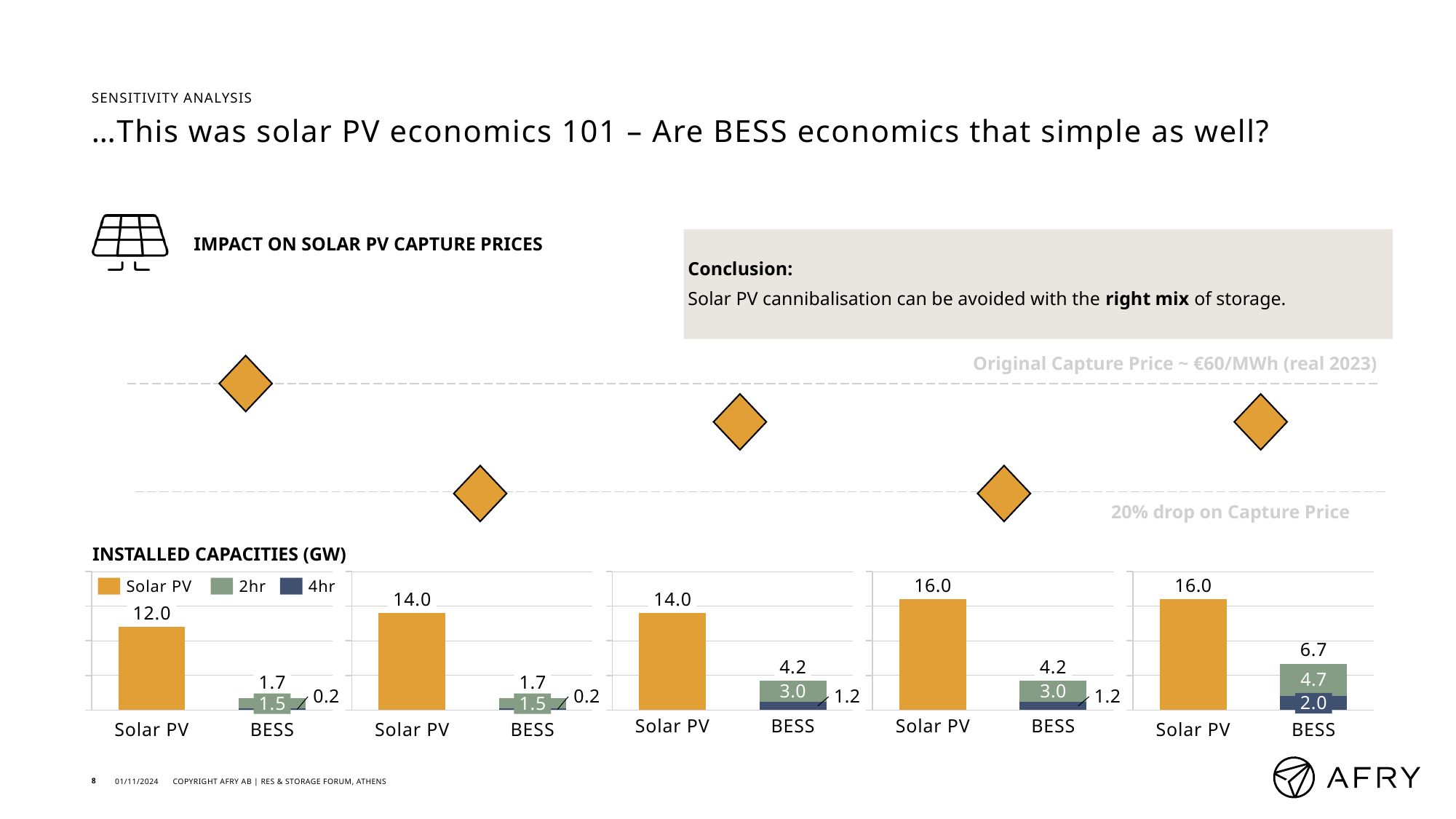
In the second installed capacities chart from the left, which is larger, Solar PV or BESS? Solar PV In the rightmost installed capacities chart, what is the 4hr value for BESS? 2.0 In the rightmost installed capacities chart, what is the total of the stacked BESS bar? 6.7 In the fourth installed capacities chart from the left, what is the difference between the Solar PV value and the BESS total? 11.8 How many categories are shown on the x axis of each installed capacities chart? 2 Which series in the installed capacities legend is shown in orange? Solar PV How many series does the legend of the installed capacities charts list? 3 What kind of chart is used for the installed capacities? bar chart In the leftmost installed capacities chart, what is the difference between the Solar PV value and the BESS total? 10.3 In the rightmost installed capacities chart, what is the 2hr value for BESS? 4.7 In the middle installed capacities chart, what is the total of the stacked BESS bar? 4.2 In the leftmost installed capacities chart, what is the value for Solar PV? 12.0